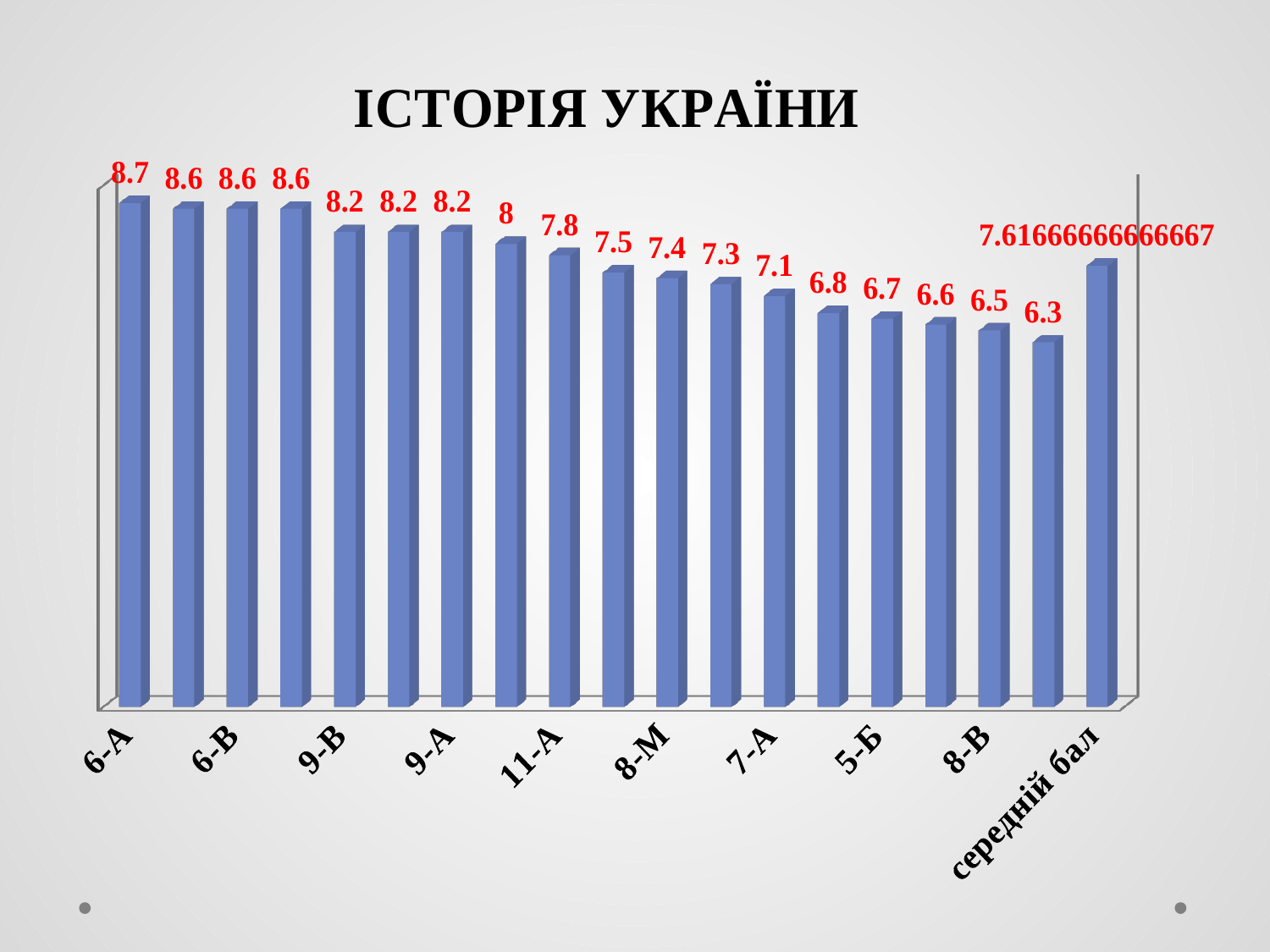
What is the title of the chart? ІСТОРІЯ УКРАЇНИ What is the value for 11-А? 7.8 Do the values generally rise or fall from left to right across the class bars (before the last bar)? Fall What kind of chart is shown on the slide? Bar chart How many bars are plotted on the chart? 19 What is the value shown for середній бал? 7.61666666666667 Which is larger, the value for 9-В or the value for 7-А? 9-В What is the value for 6-А? 8.7 What is the value for 8-В? 6.5 Which labelled category has the highest value? 6-А What is the difference between the values for 6-А and 8-В? 2.2 What is the lowest value shown on the chart? 6.3